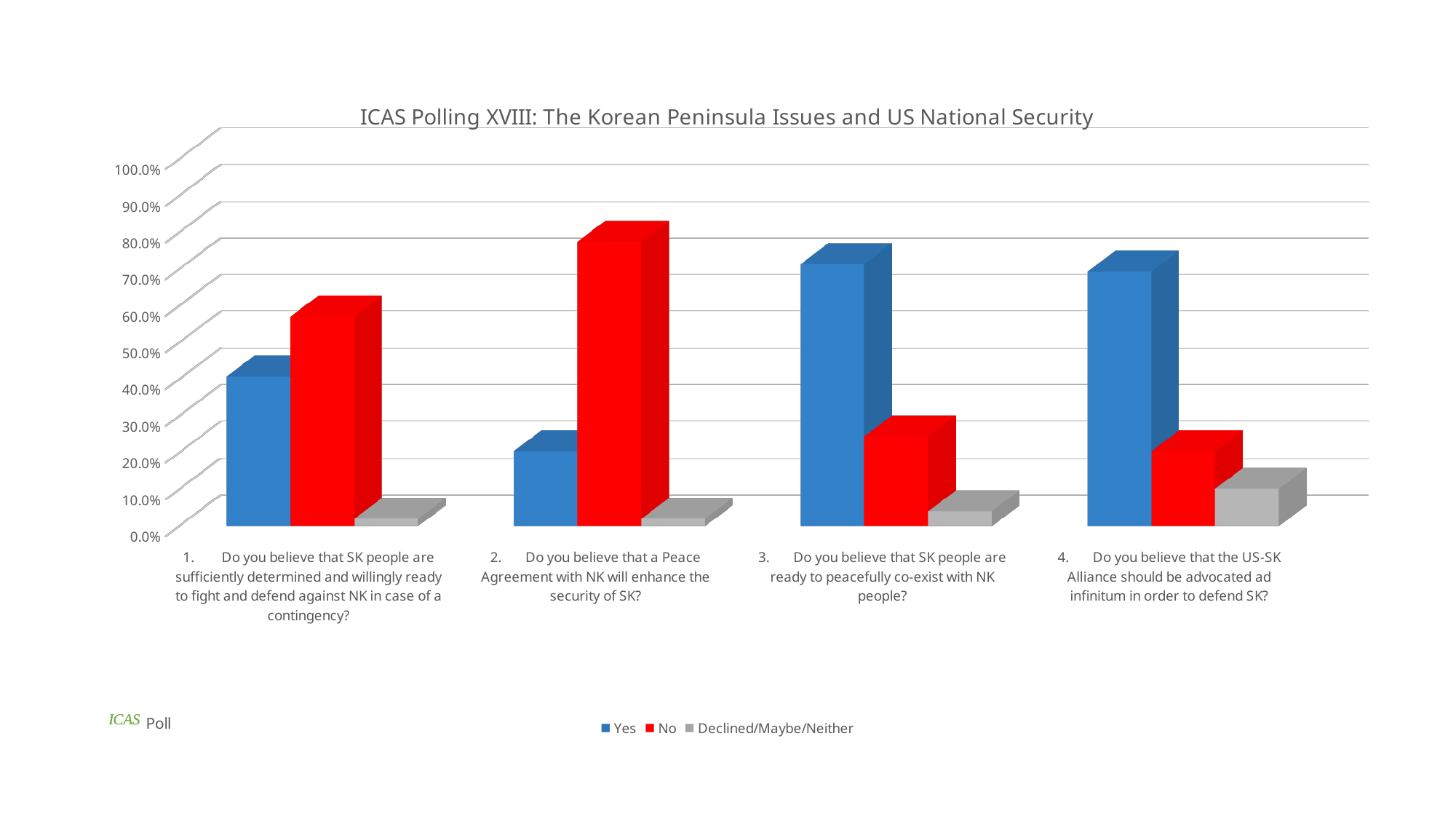
For question 3 (SK people ready to co-exist with NK), is the 'Yes' value greater or less than 60.0%? greater What kind of chart is shown on the slide? Bar chart For question 2 (Peace Agreement with NK), is the 'Yes' value greater or less than 30.0%? less What is the title of the chart? ICAS Polling XVIII: The Korean Peninsula Issues and US National Security For question 1 (SK people determined to fight), is the 'No' value greater or less than 50.0%? greater Which series is shown in red in the legend? No For question 1 (SK people determined to fight), which is larger, 'Yes' or 'No'? No How many series does the legend list? 3 Which question has the highest 'No' value? 2. Do you believe that a Peace Agreement with NK will enhance the security of SK? How many questions (categories) are plotted on the x axis? 4 For question 4 (US-SK Alliance ad infinitum), which is larger, 'Yes' or 'No'? Yes